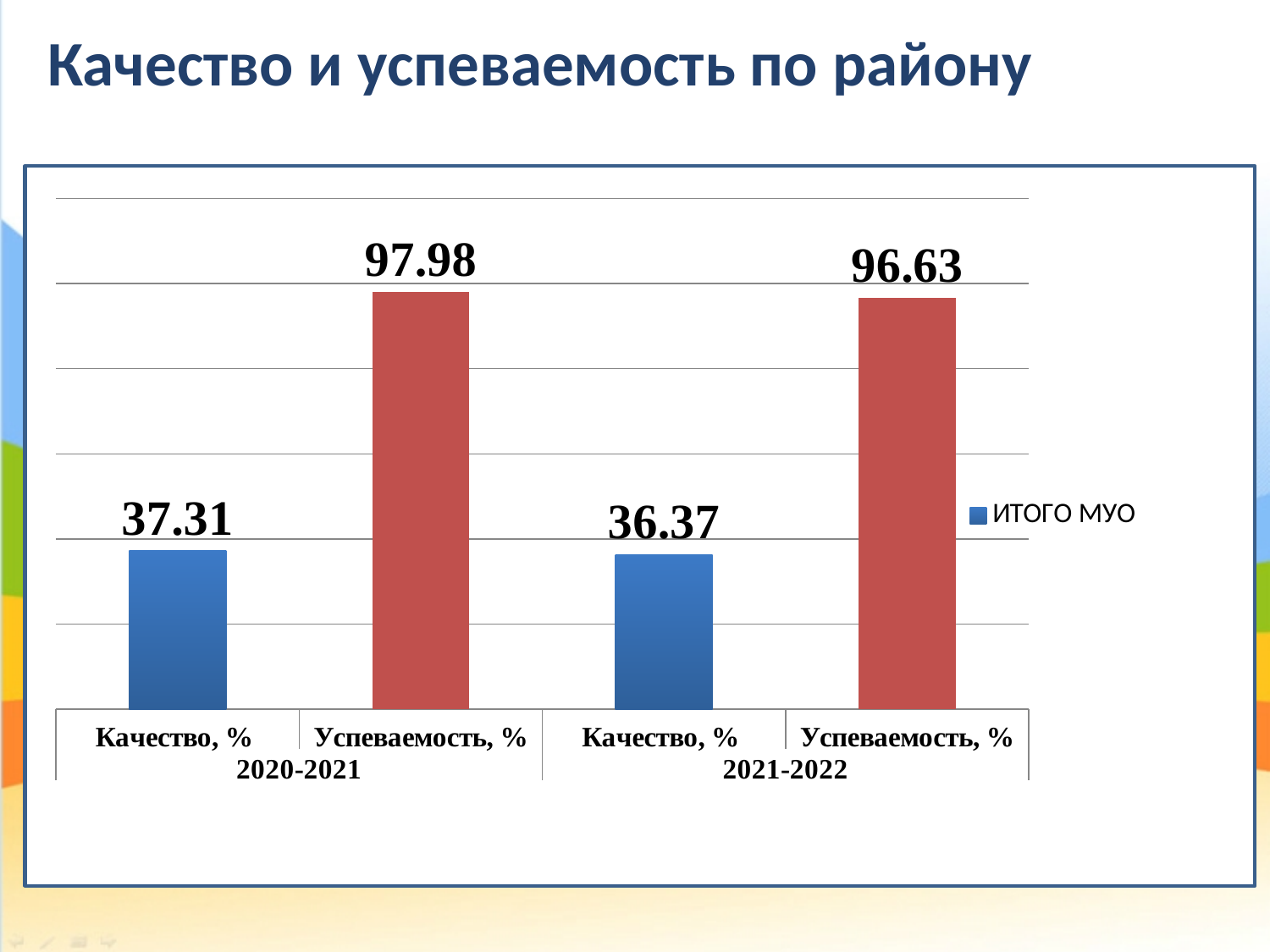
What is the legend entry shown on the chart? ИТОГО МУО What is the difference between Качество, % in 2020-2021 and in 2021-2022? 0.94 What is the difference between Успеваемость, % in 2020-2021 and in 2021-2022? 1.35 Which bar has the lowest value? Качество, % 2021-2022 What is the value for Успеваемость, % in 2020-2021? 97.98 What is the value for Качество, % in 2020-2021? 37.31 Which is larger: Качество, % in 2020-2021 or Качество, % in 2021-2022? Качество, % in 2020-2021 How many bars are plotted on the chart? 4 What is the value for Успеваемость, % in 2021-2022? 96.63 What is the value for Качество, % in 2021-2022? 36.37 What type of chart is shown on the slide? Bar chart Which bar has the highest value? Успеваемость, % 2020-2021